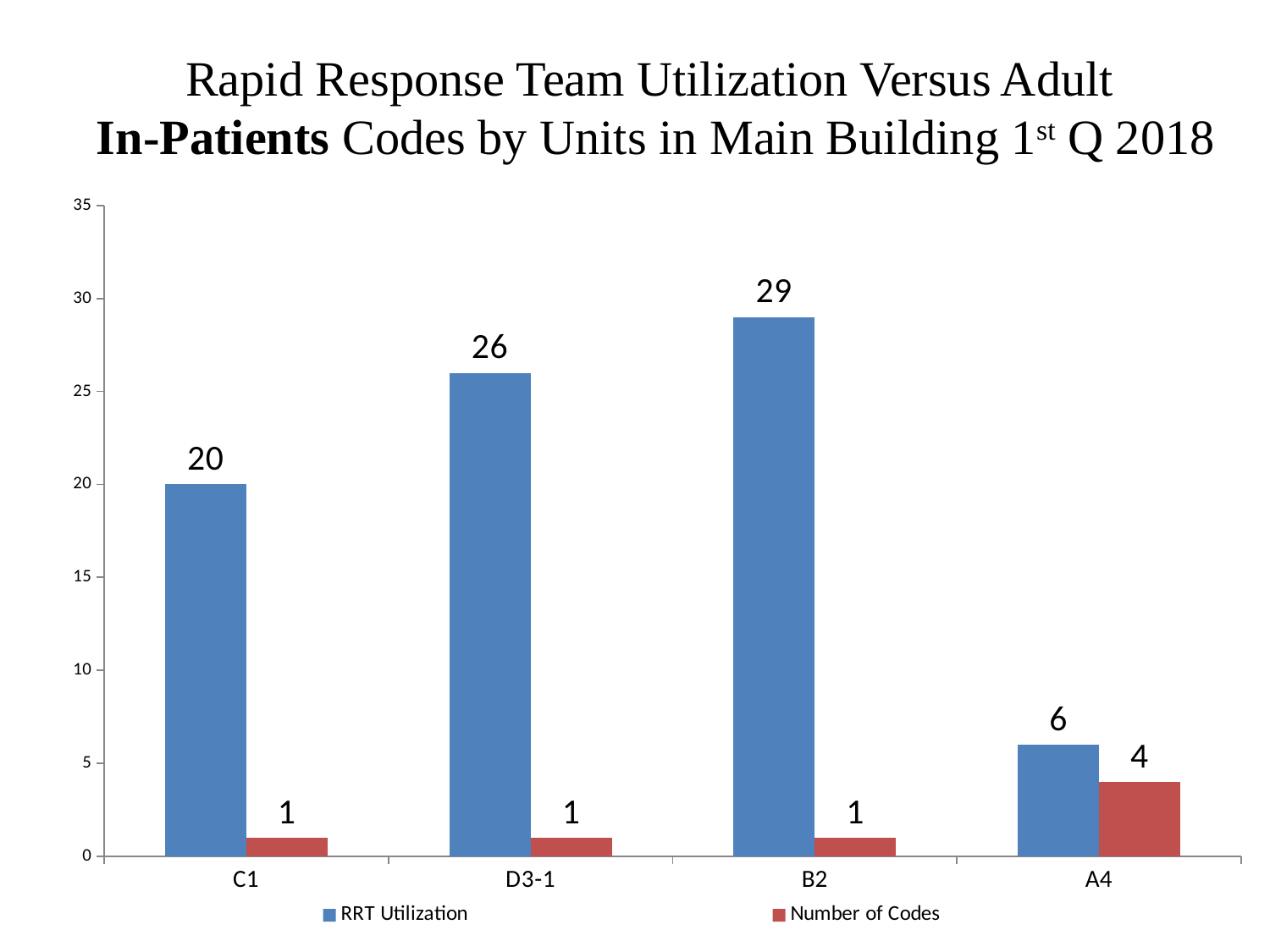
What is the Number of Codes value for unit A4? 4 How many series does the legend list? 2 What is the difference in RRT Utilization between B2 and D3-1? 3 What is the RRT Utilization value for unit B2? 29 How many units are shown on the x axis? 4 What kind of chart is shown on the slide? Bar chart Which unit has a larger RRT Utilization, C1 or D3-1? D3-1 What is the RRT Utilization value for unit C1? 20 Which unit has the highest RRT Utilization? B2 Which unit has the highest Number of Codes? A4 Which unit has the lowest RRT Utilization? A4 What is the difference between RRT Utilization and Number of Codes for unit A4? 2